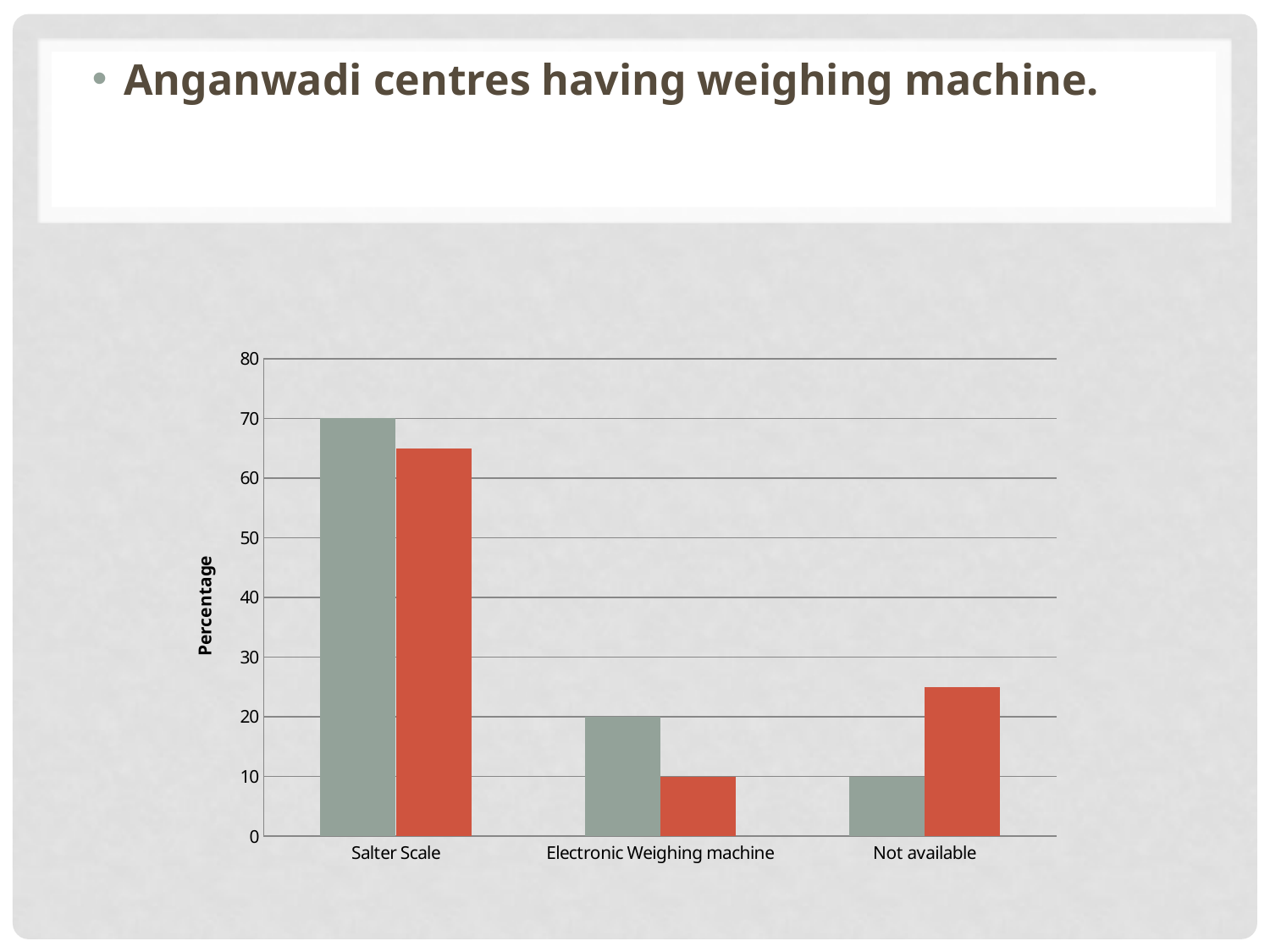
Is the value of the red bar for Salter Scale greater or less than 60? greater What is the value of the grey bar for Not available? 10 What is the value of the red bar for Electronic Weighing machine? 10 Which category has the lowest red bar? Electronic Weighing machine For Not available, which bar is larger, the grey bar or the red bar? the red bar How many categories are shown on the x axis of the chart? 3 What kind of chart is shown on the slide? bar chart What is the value of the grey bar for Electronic Weighing machine? 20 What is the difference between the grey bar for Salter Scale and the grey bar for Electronic Weighing machine? 50 Is the value of the red bar for Not available greater or less than 20? greater What is the value of the grey bar for Salter Scale? 70 Which category has the highest grey bar? Salter Scale